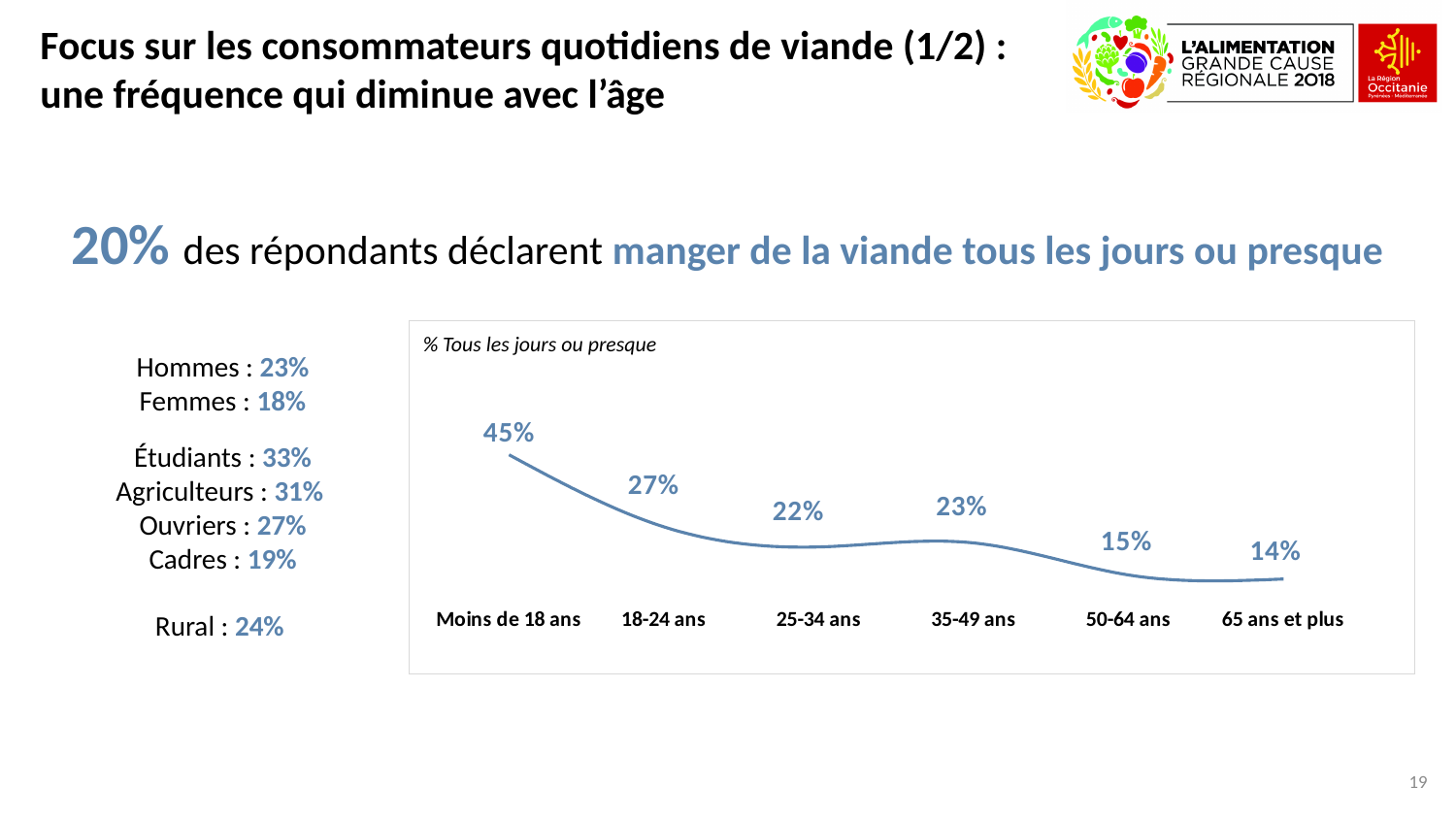
Which age group has the highest value? Moins de 18 ans What is the title shown inside the chart? % Tous les jours ou presque Which is larger, the value for '25-34 ans' or '35-49 ans'? 35-49 ans What is the difference between the values for '50-64 ans' and '65 ans et plus'? 1% What is the value for the '35-49 ans' age group? 23% Do the values generally rise or fall from the youngest to the oldest age group? Fall What is the difference between the values for 'Moins de 18 ans' and '18-24 ans'? 18% What is the value for the '65 ans et plus' age group? 14% What is the value for the 'Moins de 18 ans' age group? 45% What kind of chart is shown on the slide? Line chart Which age group has the lowest value? 65 ans et plus How many age groups are shown on the x axis? 6